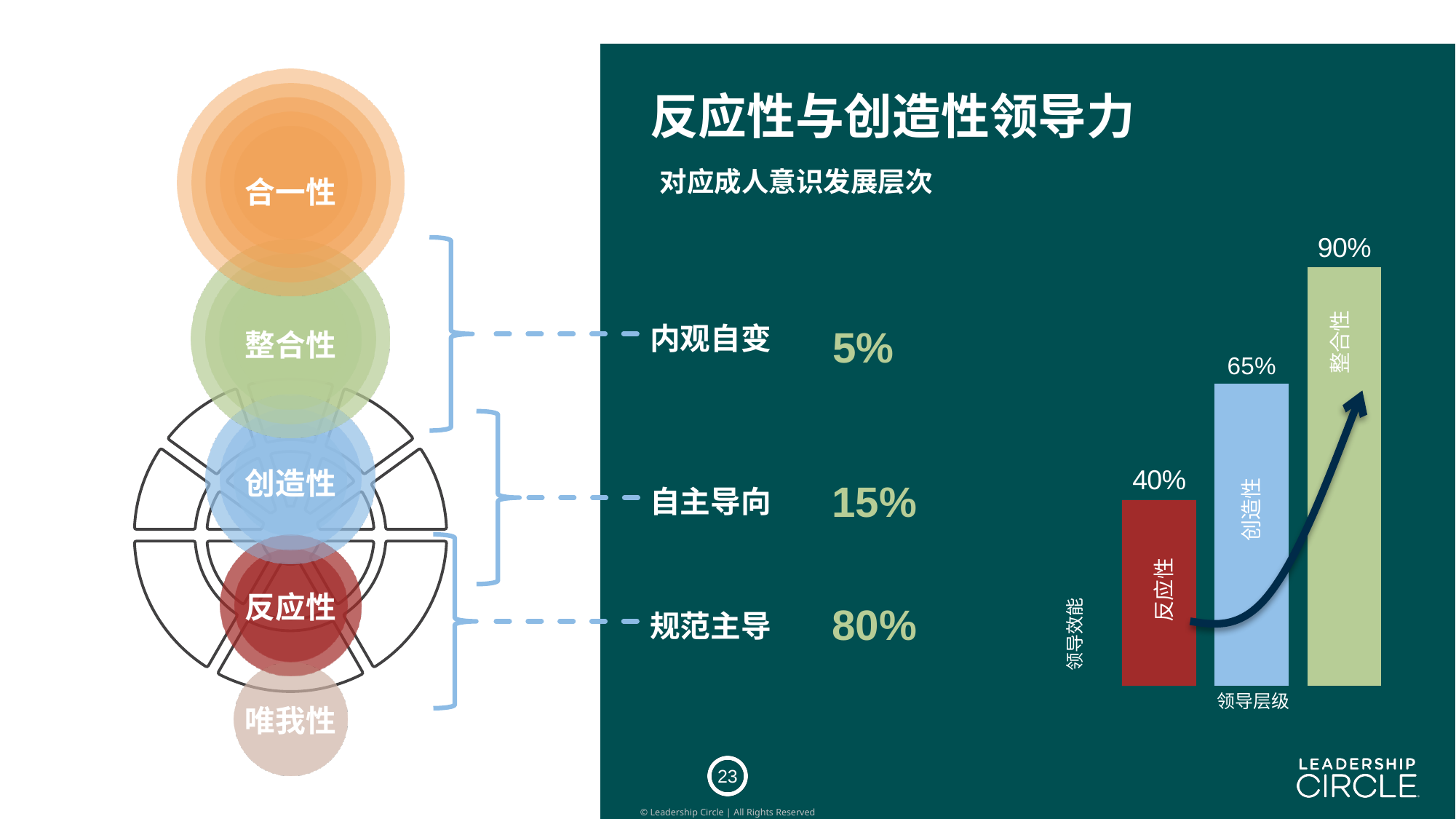
What kind of chart is shown on the right side of the slide? bar chart Which category has the lowest value in the bar chart? 反应性 What is the label on the vertical axis of the bar chart? 领导效能 Do the values in the bar chart rise or fall from left to right? rise What is the value for 整合性 in the bar chart? 90% What is the value for 反应性 in the bar chart? 40% What is the difference between the values for 整合性 and 反应性 in the bar chart? 50% How many bars are shown in the bar chart? 3 What is the difference between the values for 创造性 and 反应性 in the bar chart? 25% Which category has the highest value in the bar chart? 整合性 What is the value for 创造性 in the bar chart? 65% Which is larger in the bar chart, the value for 创造性 or the value for 整合性? 整合性